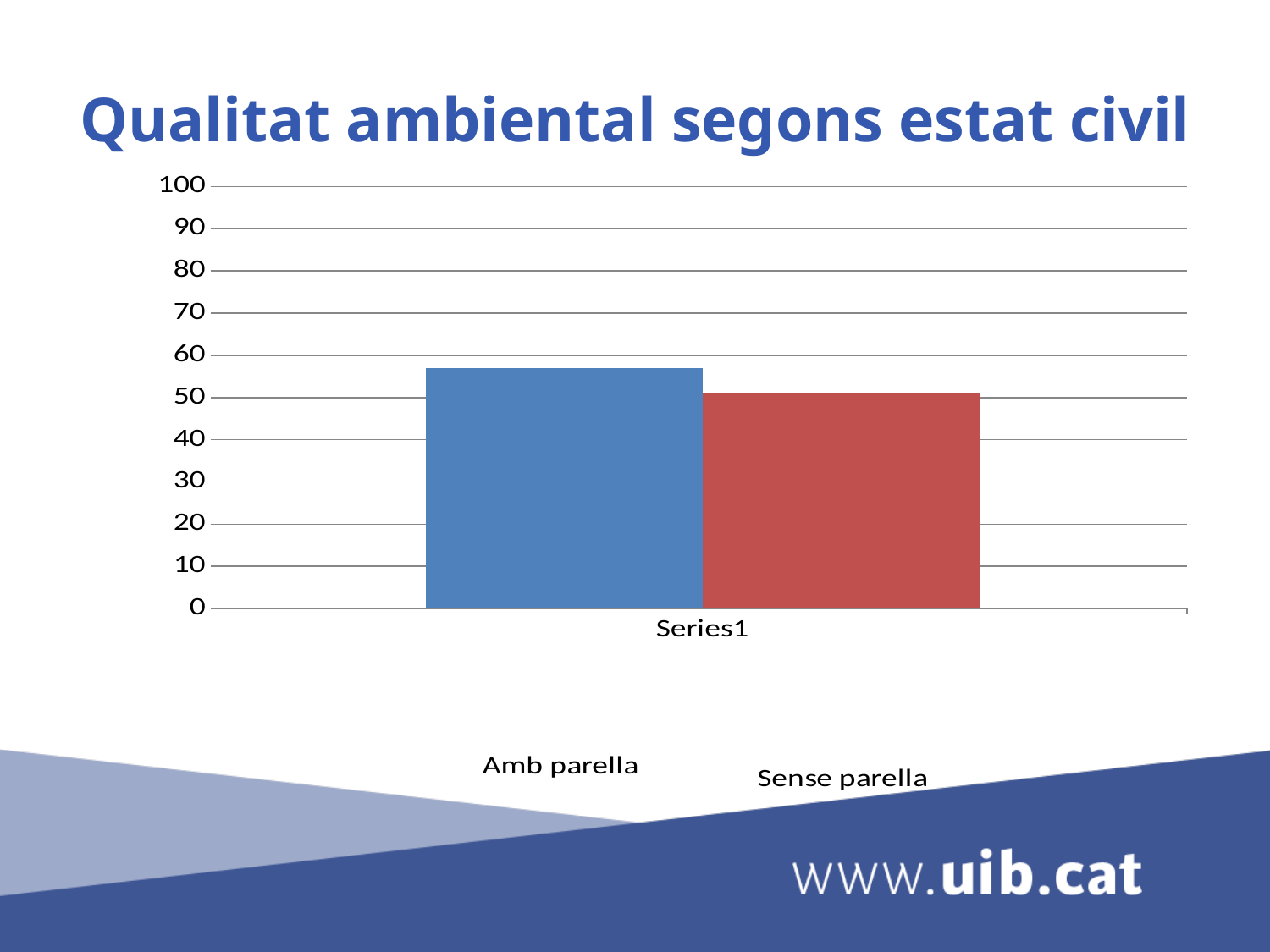
Which bar is the tallest in the chart? Amb parella Which is larger, the value for Amb parella or the value for Sense parella? Amb parella Is the value for Sense parella greater or less than 60? less Is the value for Amb parella greater or less than 60? less Which bar is the shortest in the chart? Sense parella How many bars are plotted in the chart? 2 What colour is the bar for Sense parella? Red Is the value for Sense parella greater or less than 40? greater What kind of chart is shown on the slide? Bar chart What is the title of the chart on the slide? Qualitat ambiental segons estat civil What is the highest value shown on the vertical axis of the chart? 100